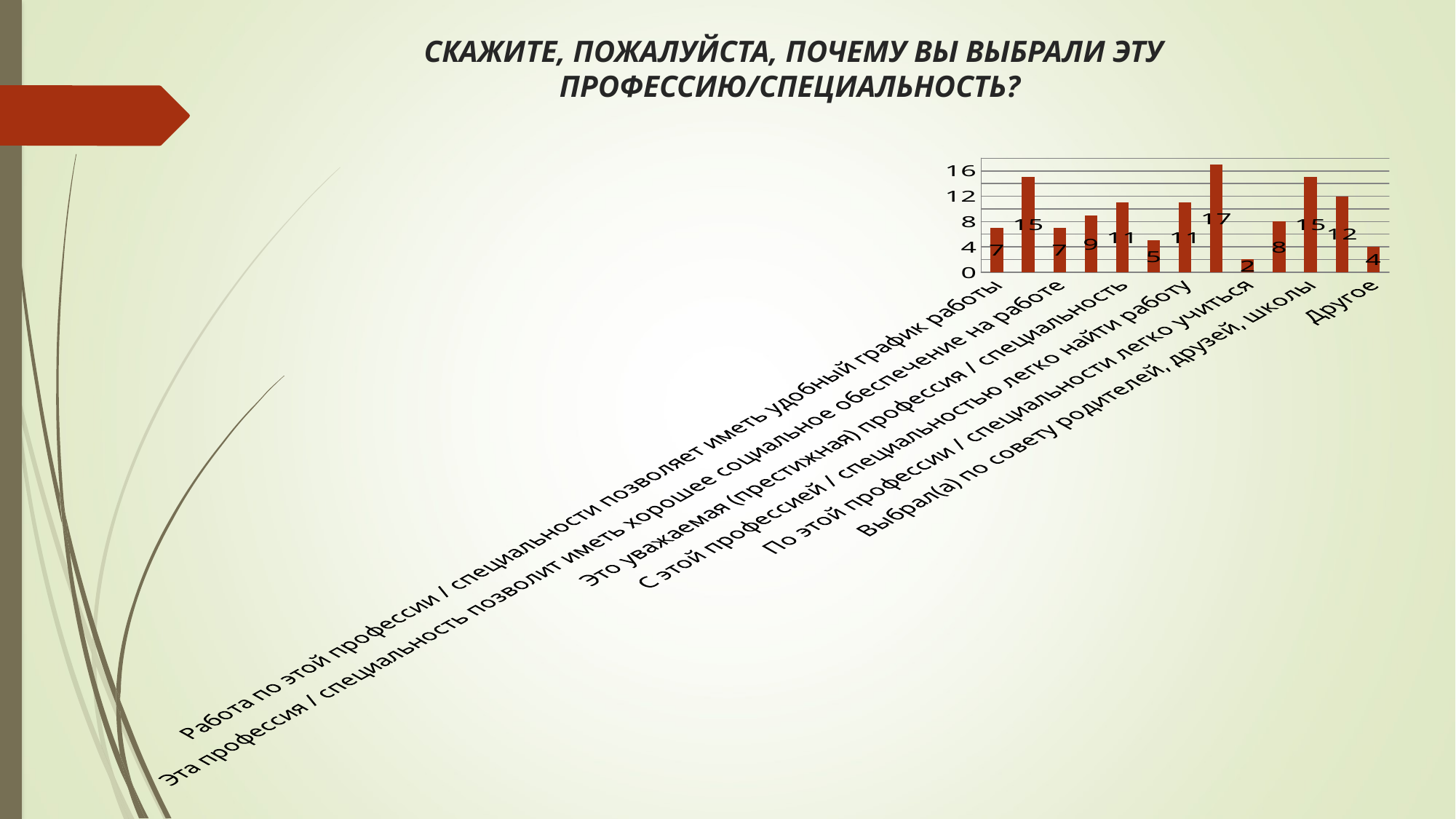
Which is larger: the first bar (удобный график работы) or the last bar (Другое)? the first bar (удобный график работы) What is the lowest value shown by any bar in the chart? 2 What is the highest value shown by any bar in the chart? 17 What kind of chart is shown on the slide? bar chart Is the value of the bar for 'Другое' greater or less than 8? less Is the value of the tallest bar greater or less than 16? greater What question is the slide title asking? СКАЖИТЕ, ПОЖАЛУЙСТА, ПОЧЕМУ ВЫ ВЫБРАЛИ ЭТУ ПРОФЕССИЮ/СПЕЦИАЛЬНОСТЬ? What is the value of the bar for 'Другое'? 4 What is the difference between the highest bar value (17) and the lowest bar value (2)? 15 What is the maximum value shown on the vertical axis of the chart? 16 What is the value of the first bar, for 'Работа по этой профессии / специальности позволяет иметь удобный график работы'? 7 How many bars are plotted in the chart? 13